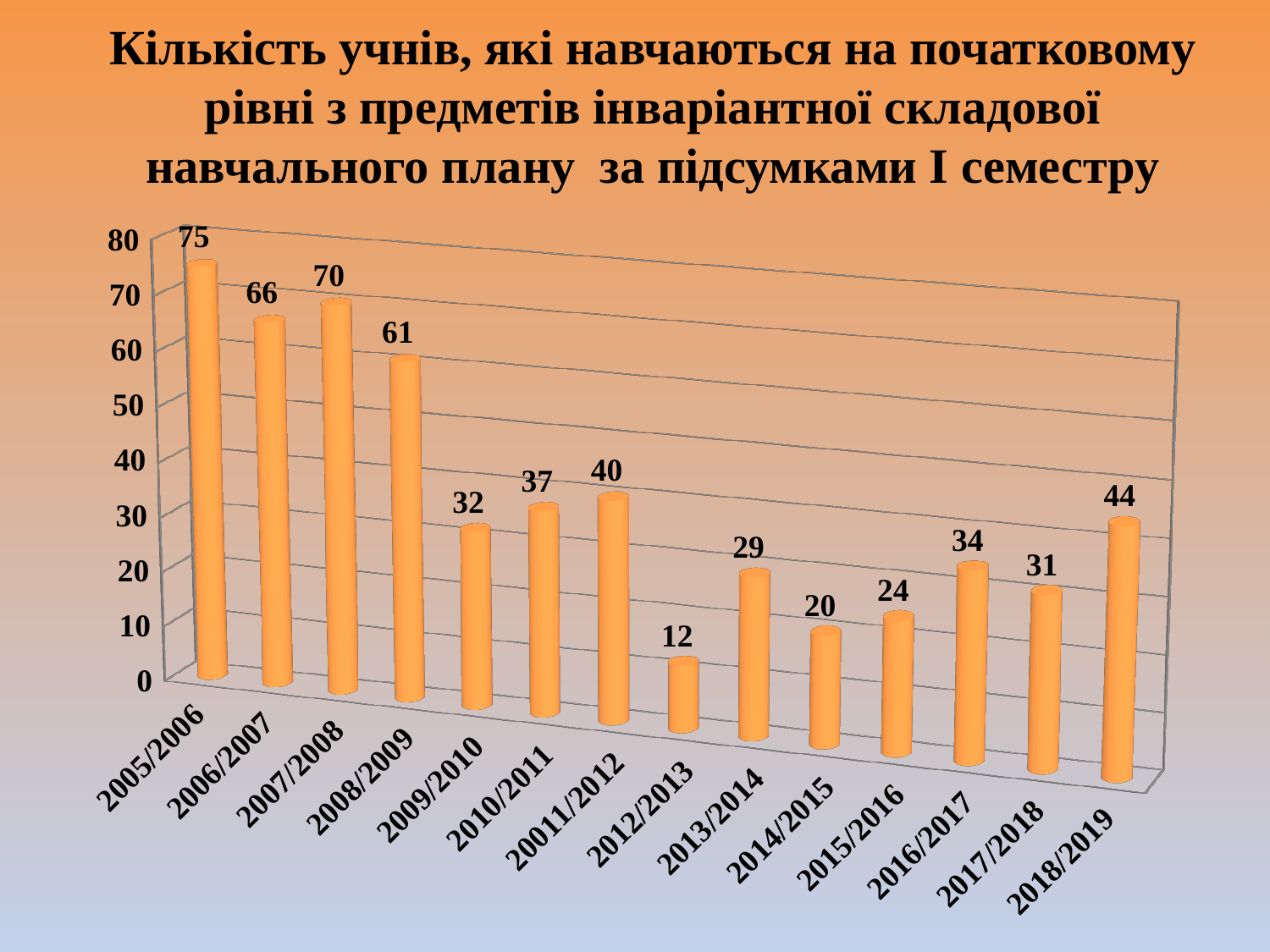
Which school year has the lowest value? 2012/2013 What is the value for 2018/2019? 44 Which school year has the highest value? 2005/2006 Do the values generally rise or fall from 2005/2006 to 2012/2013? Fall How many school years are shown on the x axis? 14 What is the difference between the values for 2005/2006 and 2018/2019? 31 What is the difference between the values for 2007/2008 and 2008/2009? 9 Which is larger, the value for 2009/2010 or the value for 2010/2011? 2010/2011 What is the value for 2016/2017? 34 What is the value for 2012/2013? 12 What kind of chart is shown on the slide? Bar chart What is the value for 2005/2006? 75